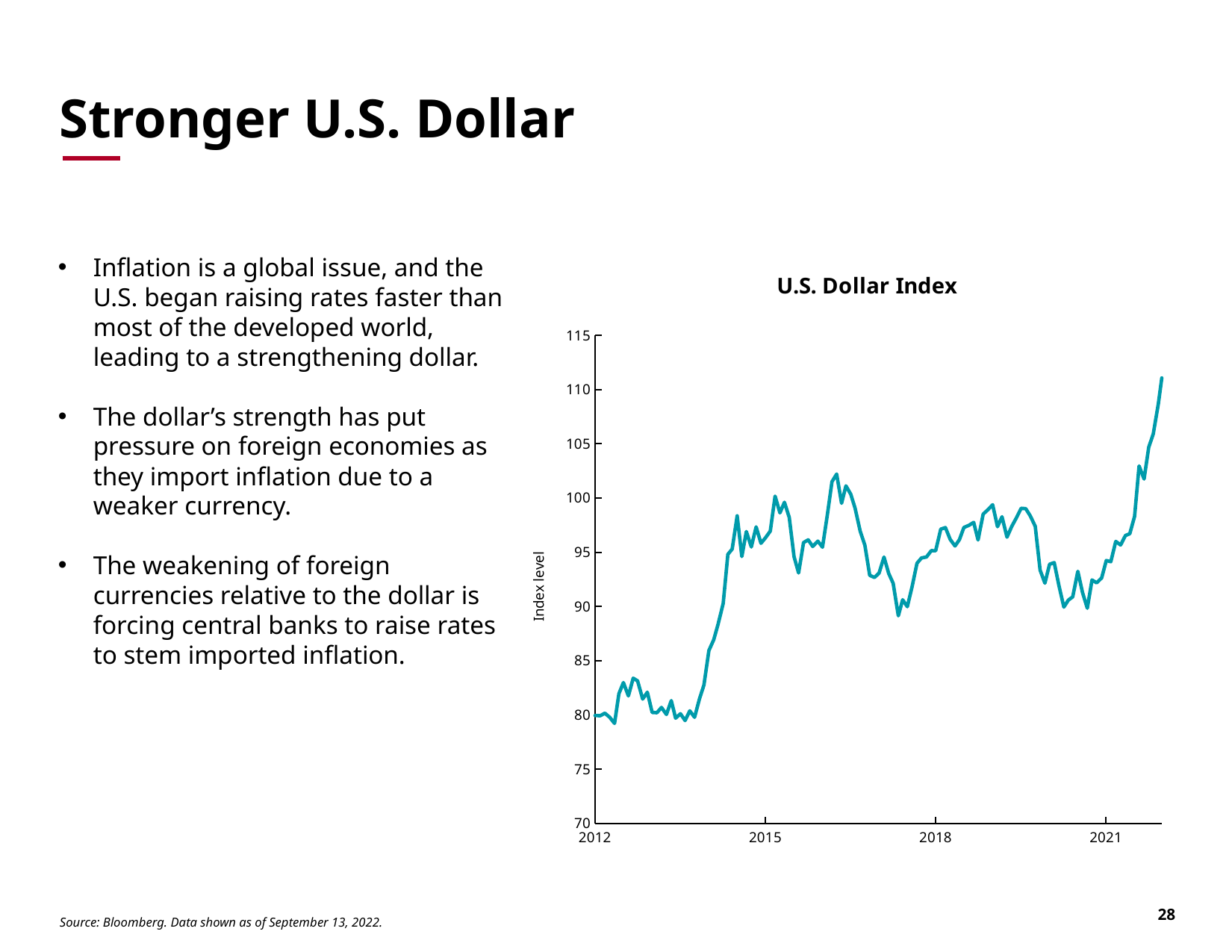
Is the lowest value of the U.S. Dollar Index on the chart greater or less than 85? less Does the U.S. Dollar Index rise or fall between 2012 and 2015? rise Does the U.S. Dollar Index reach its highest level at the start or at the end of the series? end What is the label on the vertical axis of the chart? Index level How many year labels are shown on the horizontal axis of the chart? 4 What is the title of the chart? U.S. Dollar Index Is the value of the U.S. Dollar Index at the start of 2012 greater or less than 90? less Does the U.S. Dollar Index rise or fall from 2021 to the end of the series? rise Is the value of the U.S. Dollar Index at the start of 2015 greater or less than 90? greater What kind of chart is shown on the slide? line chart